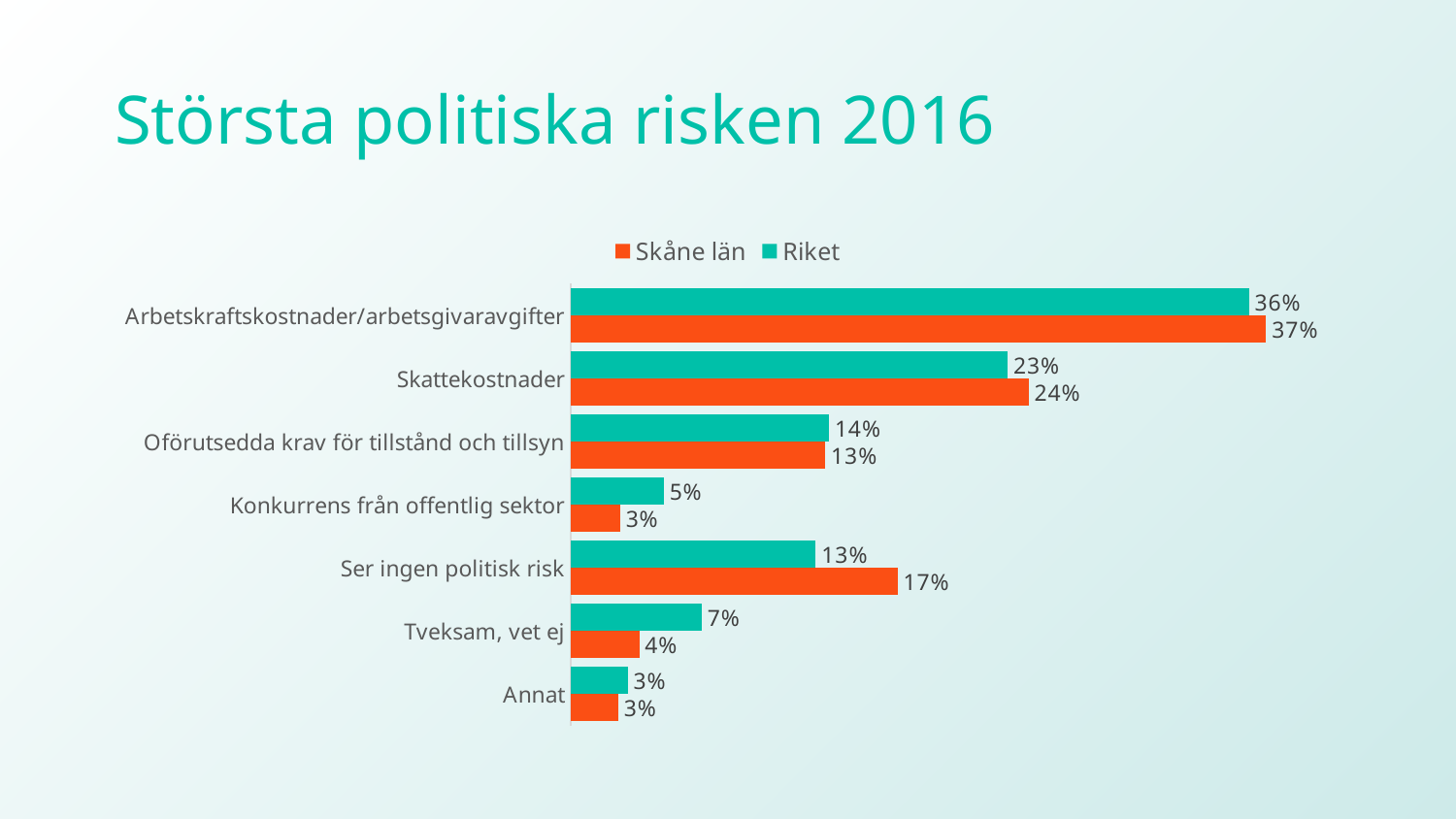
For Konkurrens från offentlig sektor, which series has the larger value, Skåne län or Riket? Riket How many categories are shown in the chart? 7 What is the difference between the Skåne län and Riket values for Ser ingen politisk risk? 4 percentage points What is the Skåne län value for Arbetskraftskostnader/arbetsgivaravgifter? 37% What is the title of the slide? Största politiska risken 2016 Which category has the lowest Riket value? Annat Which category has the highest Skåne län value? Arbetskraftskostnader/arbetsgivaravgifter How many series does the legend list? 2 What kind of chart is shown on the slide? Bar chart What is the Riket value for Tveksam, vet ej? 7% What is the Riket value for Skattekostnader? 23% What is the Skåne län value for Ser ingen politisk risk? 17%